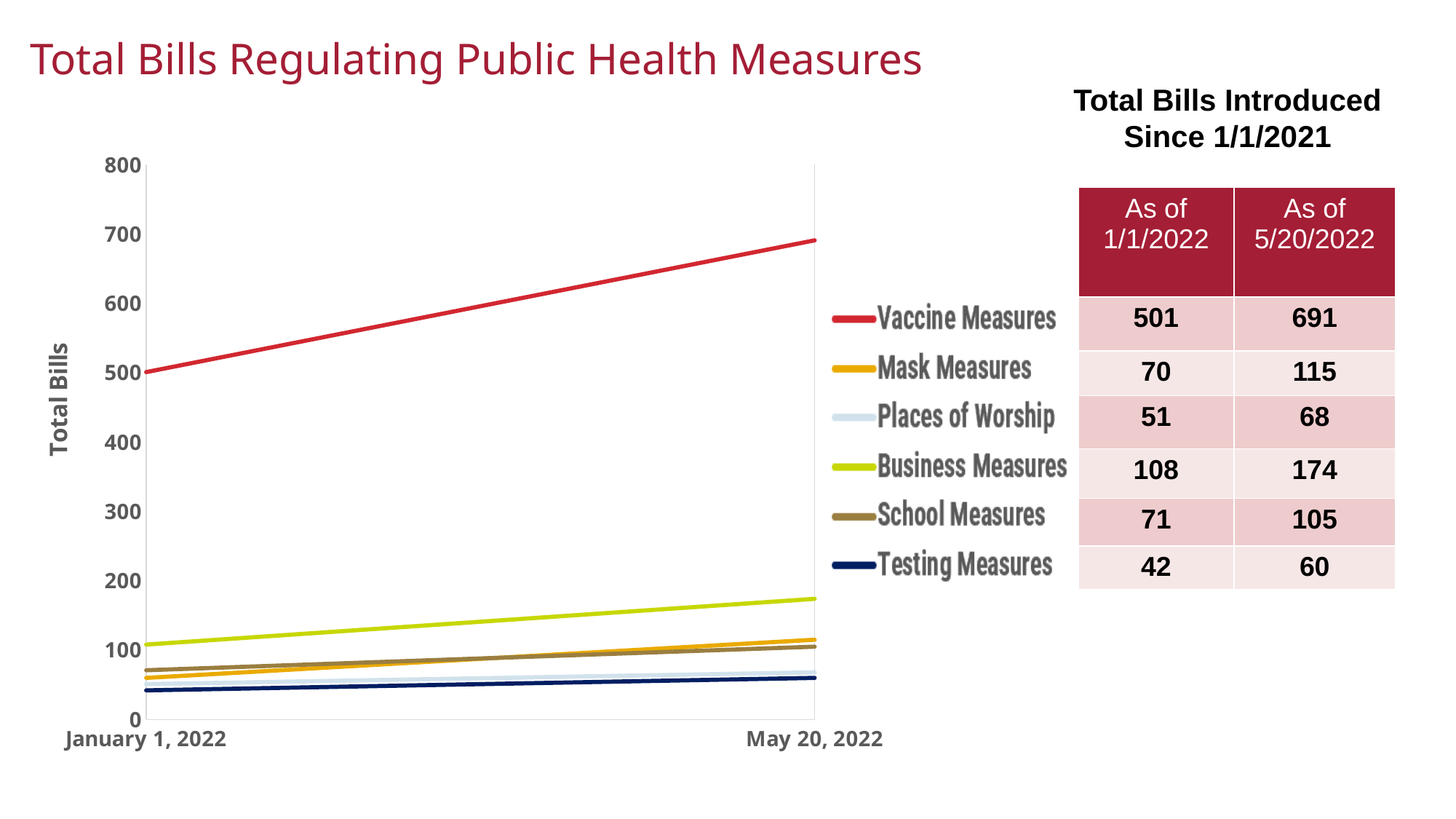
What is the value for Mask Measures as of 1/1/2022? 70 Which is larger as of 5/20/2022, Mask Measures or School Measures? Mask Measures Is the value for Vaccine Measures on May 20, 2022 greater or less than 600? greater Do the values for Places of Worship rise or fall from January 1, 2022 to May 20, 2022? rise Which series has the highest value as of 5/20/2022? Vaccine Measures What is the difference between Business Measures and School Measures as of 5/20/2022? 69 How many series does the chart's legend list? 6 By how much did Vaccine Measures increase from 1/1/2022 to 5/20/2022? 190 What is the value for Vaccine Measures as of 5/20/2022? 691 What kind of chart is shown on the slide? line chart Which series has the lowest value as of 1/1/2022? Testing Measures What is the label on the chart's vertical axis? Total Bills